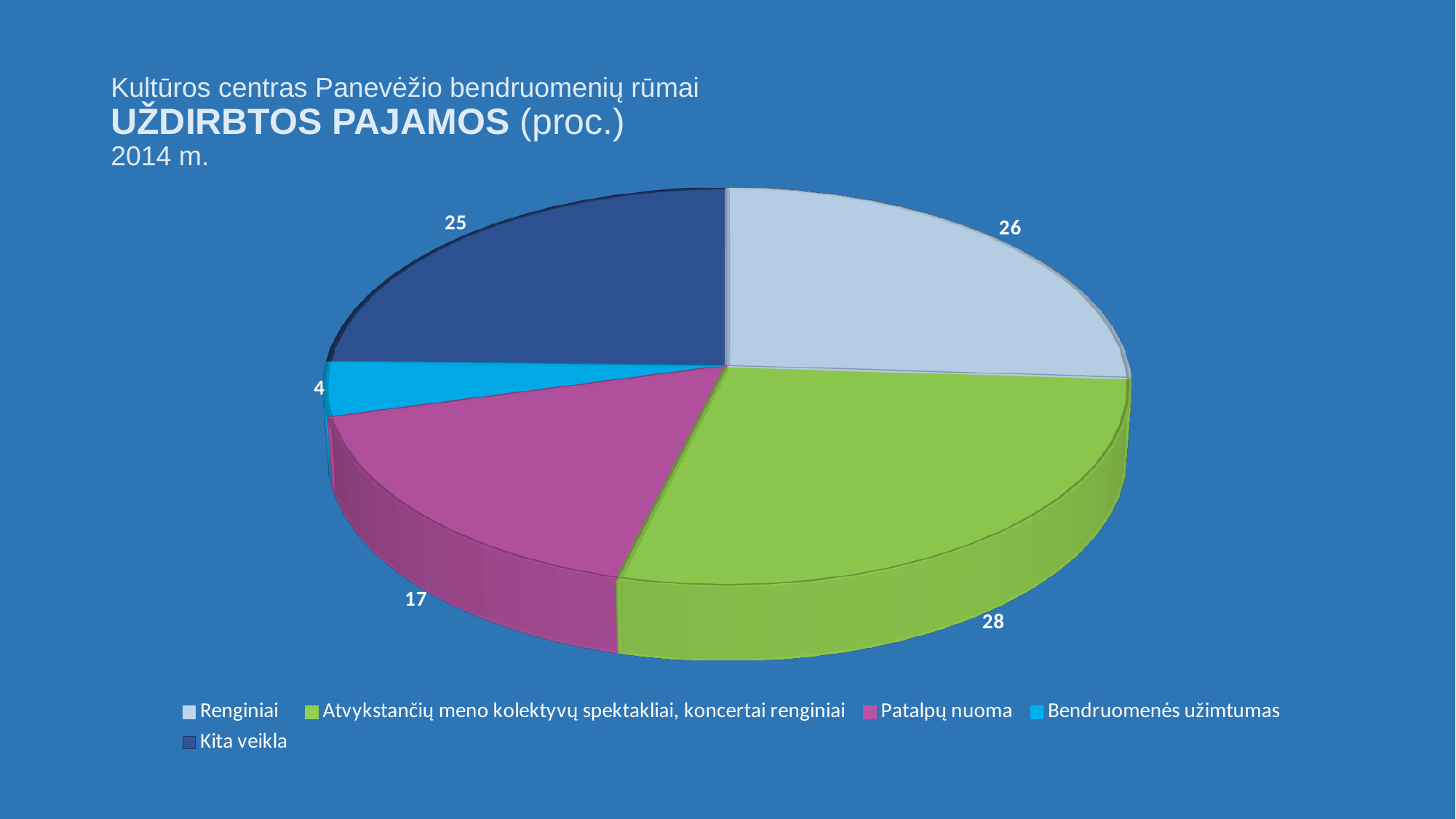
Which category has the smallest slice? Bendruomenės užimtumas What is the difference between the values for Renginiai and Patalpų nuoma? 9 What is the value for Kita veikla? 25 Which is larger, the value for Patalpų nuoma or the value for Kita veikla? Kita veikla What is the value for Bendruomenės užimtumas? 4 What is the value for Renginiai? 26 What kind of chart is shown on the slide? pie chart Which category has the largest slice? Atvykstančių meno kolektyvų spektakliai, koncertai renginiai Which year does the chart title refer to? 2014 m. What is the value for Atvykstančių meno kolektyvų spektakliai, koncertai renginiai? 28 What is the value for Patalpų nuoma? 17 How many categories does the pie chart have? 5